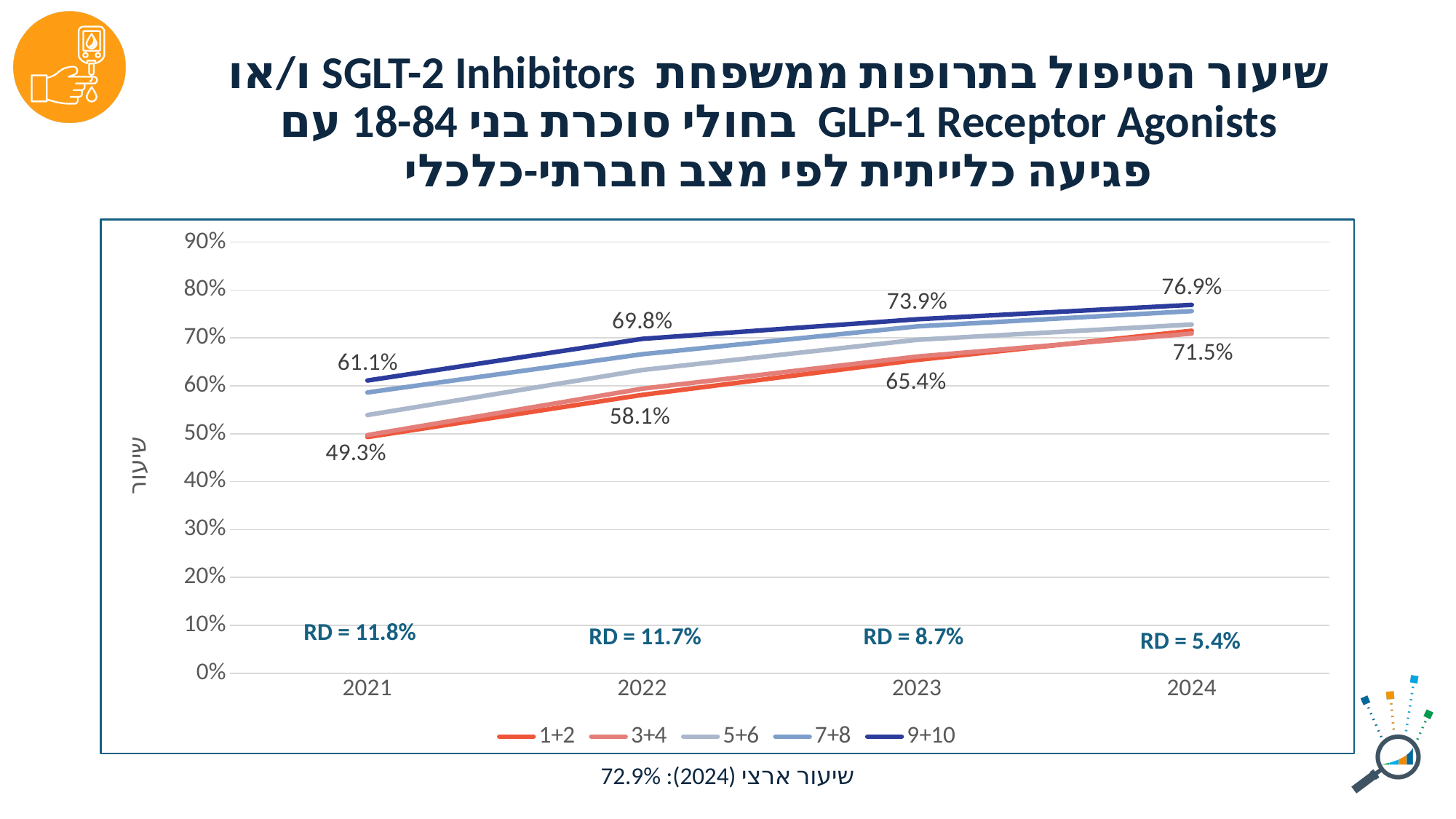
What is the value for the 9+10 series in 2024? 76.9% What is the difference between the 9+10 and 1+2 series in 2024? 5.4% What is the difference between the 9+10 and 1+2 series in 2021? 11.8% What is the value for the 9+10 series in 2022? 69.8% Is the value for the 5+6 series in 2021 greater or less than 60%? less What is the value for the 1+2 series in 2023? 65.4% What kind of chart is shown on the slide? line chart What is the value for the 1+2 series in 2021? 49.3% How many series does the legend list? 5 Which year has the lowest value for the 9+10 series? 2021 Which series has the highest value in 2024? 9+10 Do the values for the 1+2 series rise or fall from 2021 to 2024? rise